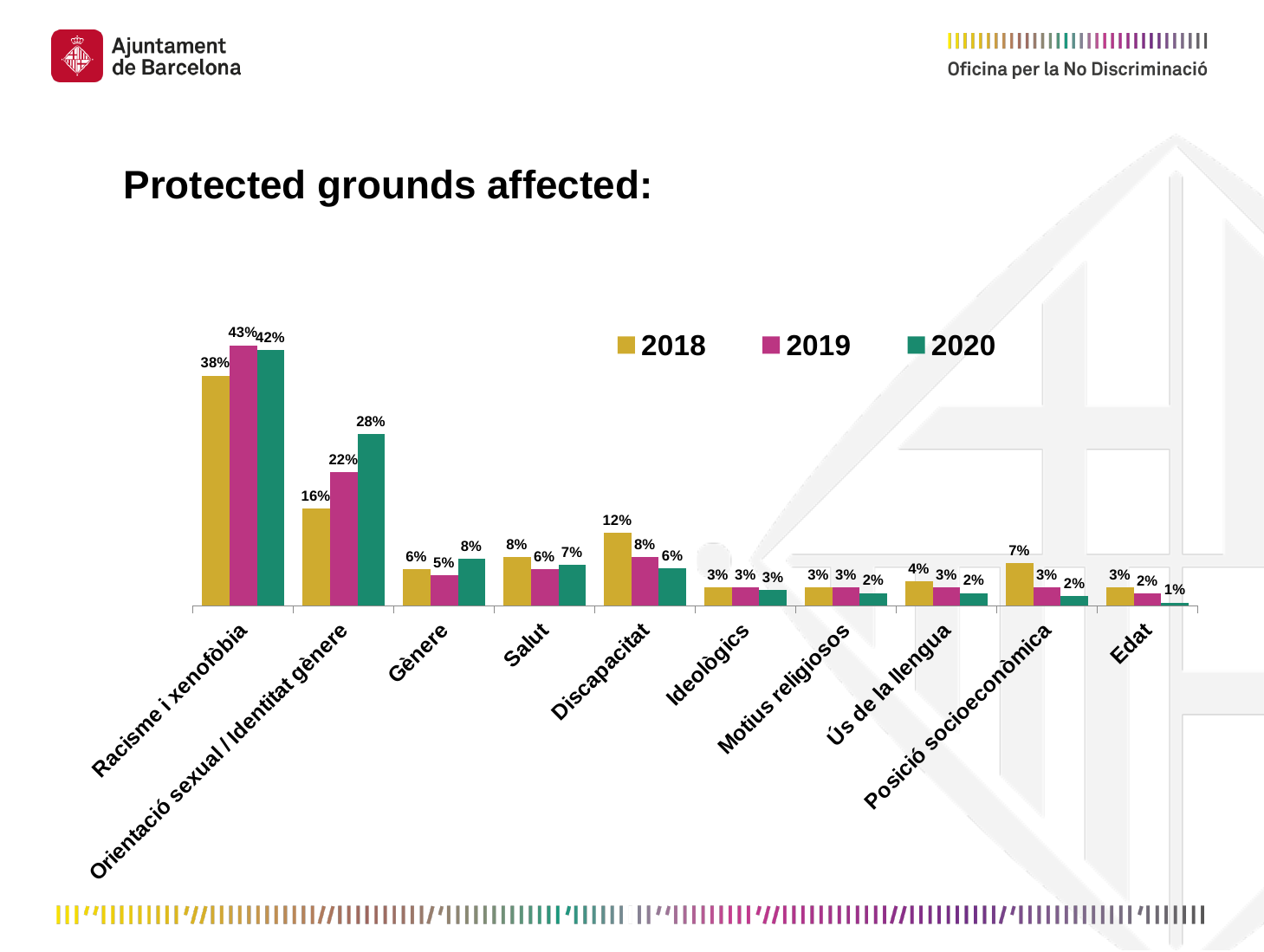
Which series is shown in green in the legend? 2020 Does the value for Salut rise or fall from 2018 to 2019? fall What is the difference between the 2020 and 2018 values for Orientació sexual / Identitat gènere? 12% What is the value for Racisme i xenofòbia in 2019? 43% Which category has the highest value in 2020? Racisme i xenofòbia What kind of chart is shown on the slide? bar chart Which category has the lowest value in 2020? Edat How many series does the legend list? 3 How many categories are shown on the x axis? 10 What is the value for Orientació sexual / Identitat gènere in 2020? 28% What is the value for Discapacitat in 2018? 12% Which is larger for Posició socioeconòmica: the 2018 value or the 2019 value? 2018